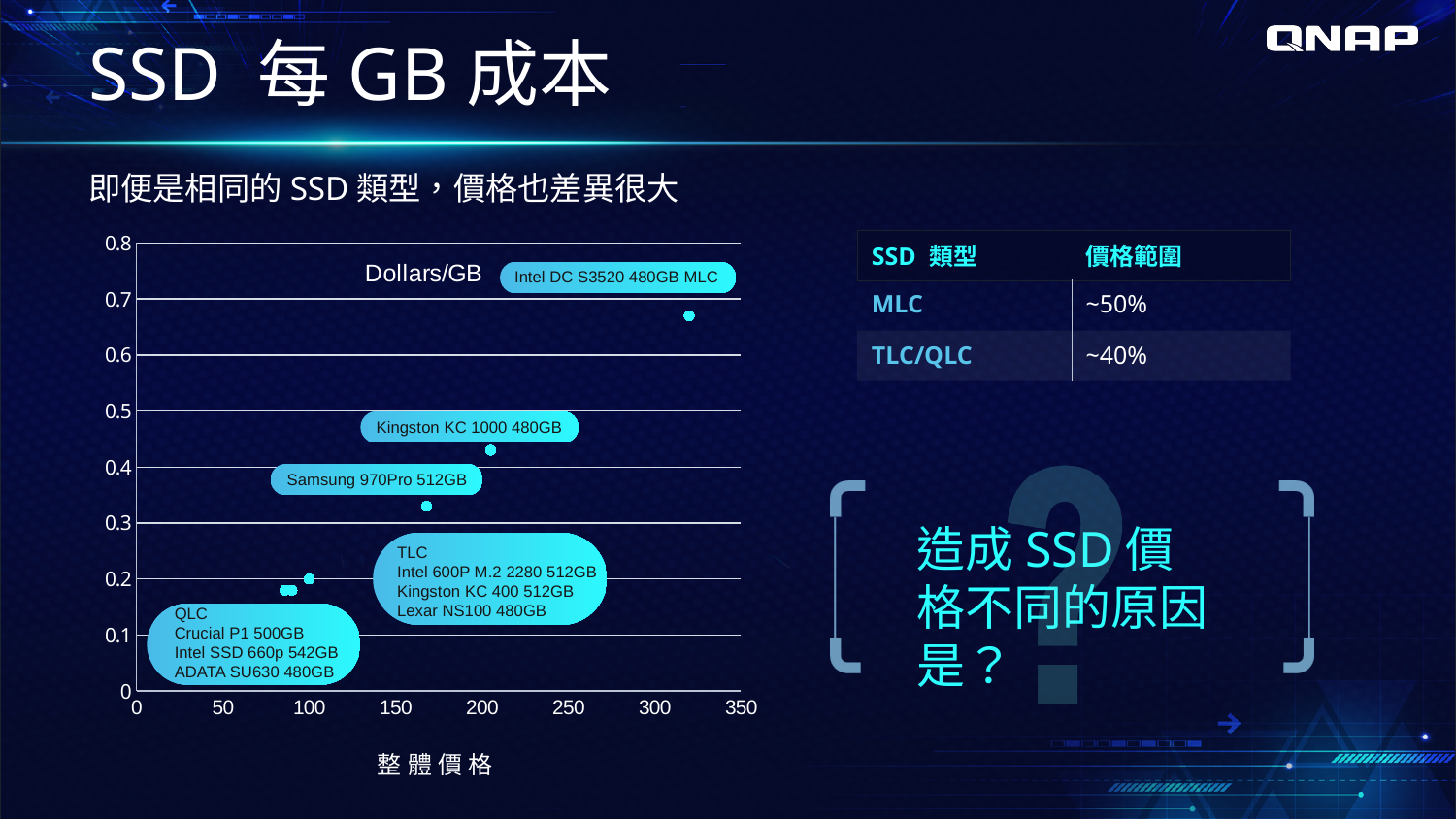
Which has the higher Dollars/GB value, Intel DC S3520 480GB MLC or Kingston KC 1000 480GB? Intel DC S3520 480GB MLC What kind of chart is shown on the slide? scatter chart Which has the higher Dollars/GB value, Kingston KC 1000 480GB or Samsung 970Pro 512GB? Kingston KC 1000 480GB Is the Dollars/GB value for Samsung 970Pro 512GB greater or less than 0.4? less Is the Dollars/GB value for Kingston KC 1000 480GB greater or less than 0.4? greater Is the overall price (x-axis) of Intel DC S3520 480GB MLC greater or less than 300? greater What is the title shown inside the chart? Dollars/GB What is the label of the x axis of the chart? 整體價格 Which labelled SSD has the highest Dollars/GB value in the chart? Intel DC S3520 480GB MLC